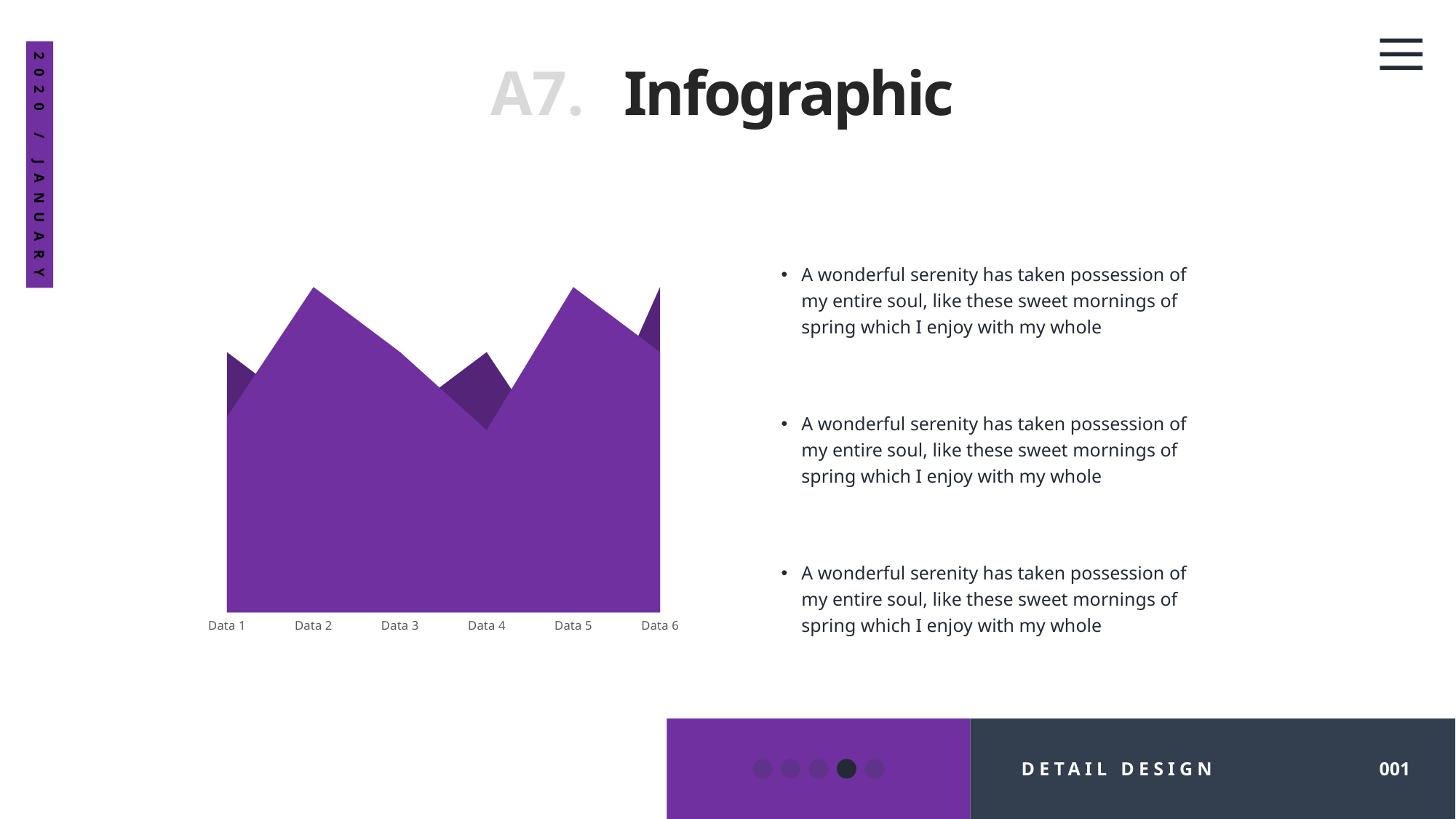
Does the front (lighter purple) series rise or fall from Data 2 to Data 4? Fall How many categories are shown along the x axis of the chart? 6 For the front (lighter purple) series, which is larger, the value at Data 4 or the value at Data 5? Data 5 What is the label of the last category on the x axis? Data 6 What is the label of the first category on the x axis? Data 1 For the front (lighter purple) series, which is larger, the value at Data 2 or the value at Data 3? Data 2 For the front (lighter purple) series, which is larger, the value at Data 1 or the value at Data 2? Data 2 What kind of chart is shown on the slide? Area chart Does the front (lighter purple) series rise or fall from Data 1 to Data 2? Rise Does the front (lighter purple) series rise or fall from Data 4 to Data 5? Rise For the front (lighter purple) series, which category has the lowest value? Data 4